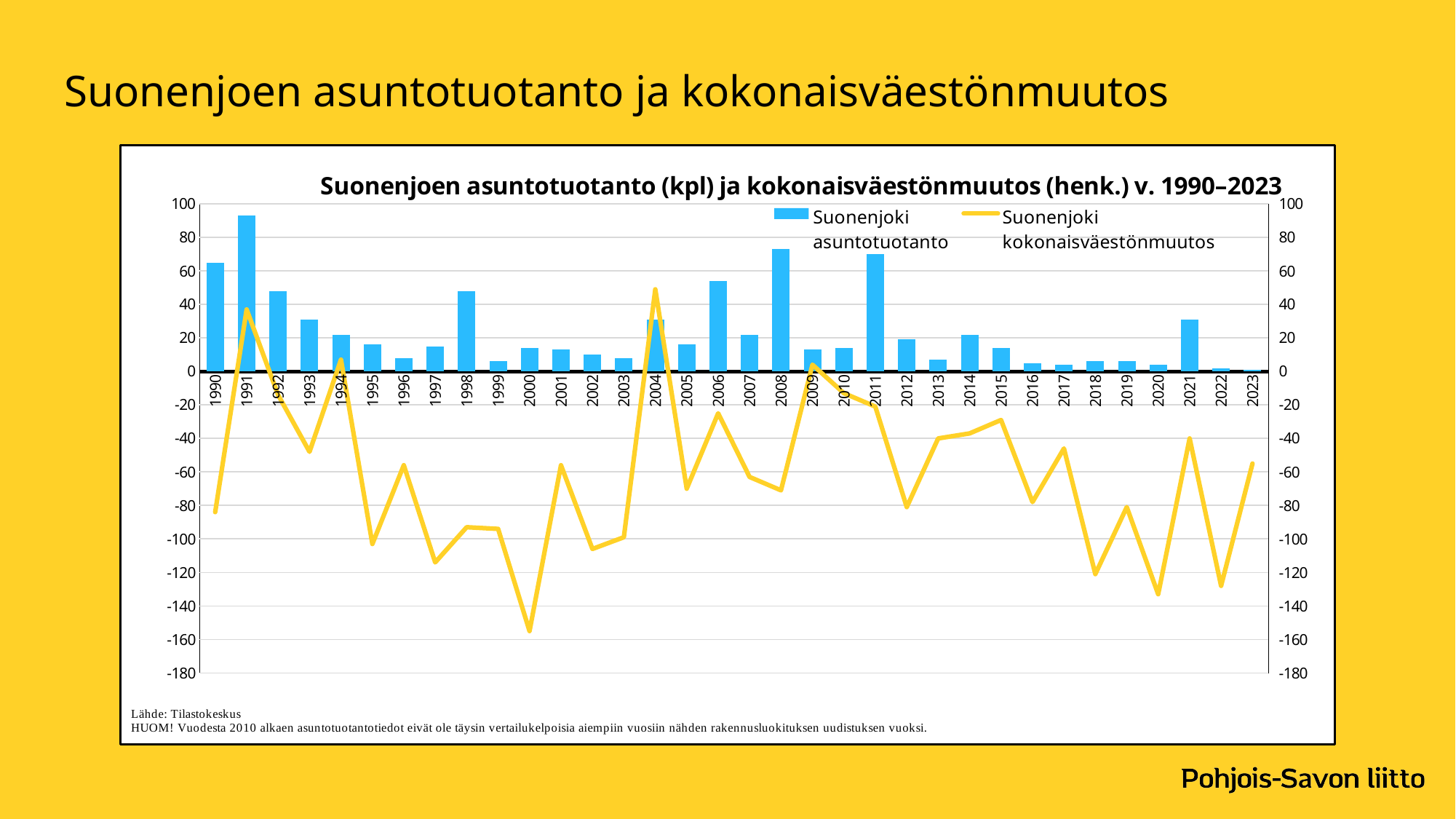
Is the Suonenjoki kokonaisväestönmuutos value for 2020 greater or less than -120? less Which year has the highest bar for Suonenjoki asuntotuotanto? 1991 In which year does the Suonenjoki kokonaisväestönmuutos line reach its highest point? 2004 Is the Suonenjoki asuntotuotanto bar for 2016 greater or less than 20? less Is the Suonenjoki kokonaisväestönmuutos value for 2000 greater or less than -140? less Which year has the taller Suonenjoki asuntotuotanto bar, 1990 or 1992? 1990 In which year does the Suonenjoki kokonaisväestönmuutos line reach its lowest point? 2000 Do the Suonenjoki asuntotuotanto bars rise or fall from 1991 to 1995? fall How many series does the legend list? 2 What kind of chart is shown on the slide? A combined bar and line chart How many years are shown on the x axis? 34